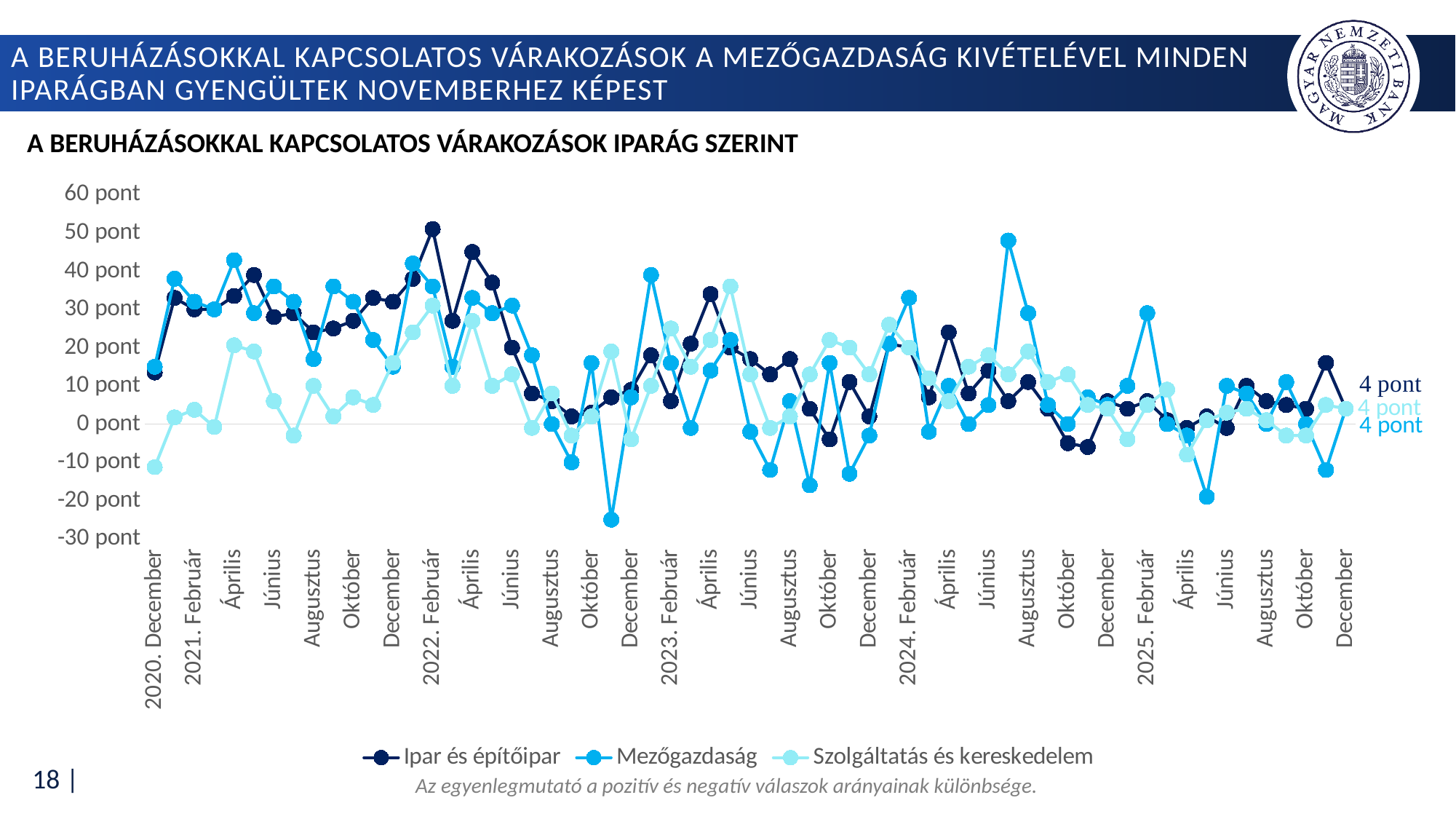
What is the value of Ipar és építőipar in 2025 December? 4 pont Is the value for Mezőgazdaság in 2024 August greater or less than 40 pont? less Which series has the highest value in 2022 February? Ipar és építőipar In 2024 August, which is larger: Mezőgazdaság or Ipar és építőipar? Mezőgazdaság What kind of chart is shown on the slide? line chart Is the value for Ipar és építőipar in 2022 February greater or less than 40 pont? greater What is the title of the chart? A BERUHÁZÁSOKKAL KAPCSOLATOS VÁRAKOZÁSOK IPARÁG SZERINT Is the value for Mezőgazdaság in 2022 October greater or less than -20 pont? greater What is the value of Szolgáltatás és kereskedelem in 2025 December? 4 pont How many series does the legend list? 3 What is the value of Mezőgazdaság in 2025 December? 4 pont